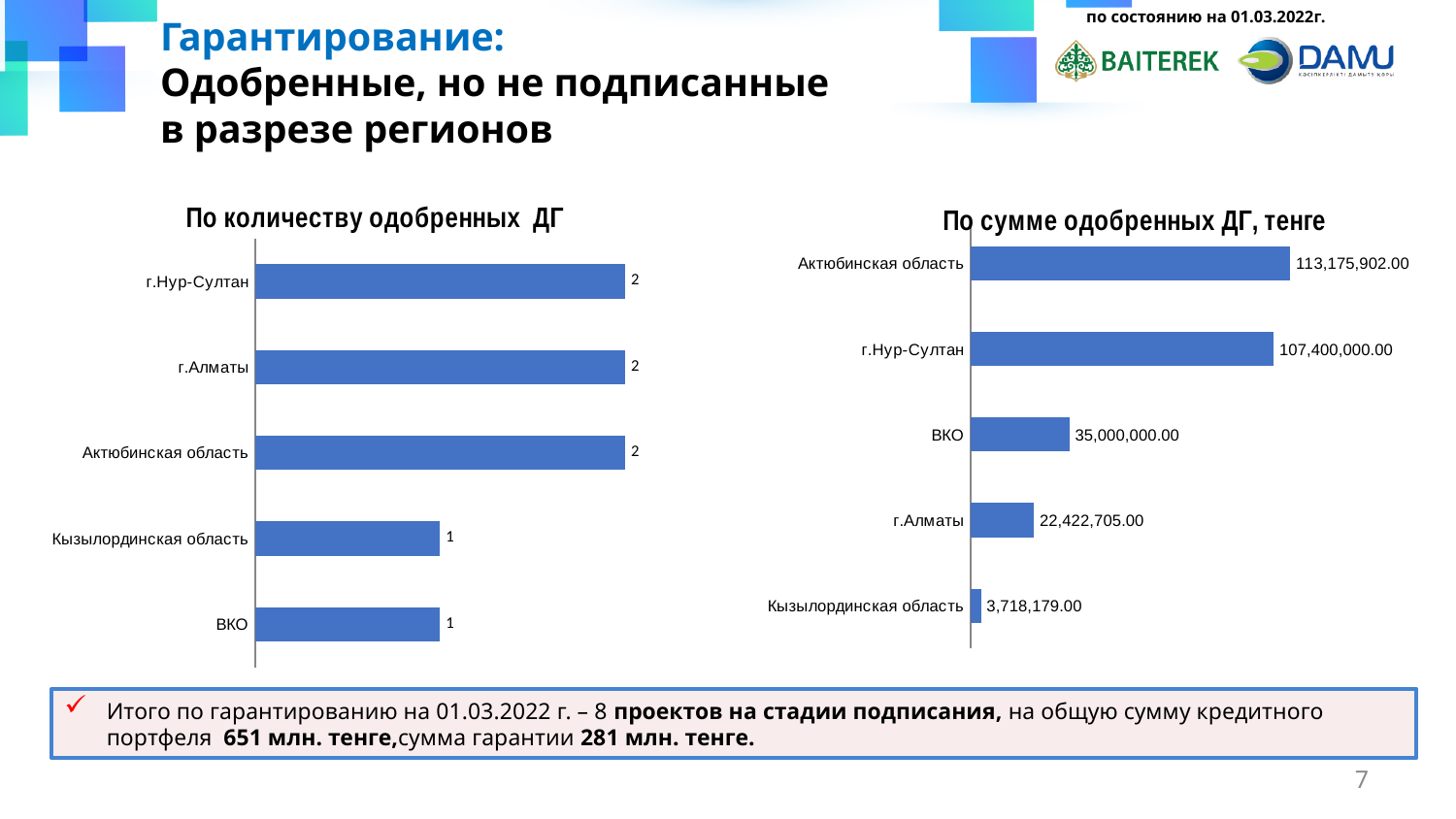
In the chart 'По количеству одобренных ДГ', what is the value for Кызылординская область? 1 In the chart 'По сумме одобренных ДГ, тенге', which is larger: the value for ВКО or the value for г.Алматы? ВКО In the chart 'По сумме одобренных ДГ, тенге', what is the difference between the values for Актюбинская область and г.Нур-Султан? 5,775,902.00 In the chart 'По сумме одобренных ДГ, тенге', what is the value for ВКО? 35,000,000.00 In the chart 'По сумме одобренных ДГ, тенге', which category has the highest value? Актюбинская область In the chart 'По количеству одобренных ДГ', how many categories are shown? 5 What is the title of the chart on the left side of the slide? По количеству одобренных ДГ In the chart 'По сумме одобренных ДГ, тенге', what is the value for г.Нур-Султан? 107,400,000.00 What kind of chart is 'По сумме одобренных ДГ, тенге'? bar chart In the chart 'По количеству одобренных ДГ', what is the value for г.Алматы? 2 In the chart 'По количеству одобренных ДГ', what is the total of all the plotted values? 8 In the chart 'По сумме одобренных ДГ, тенге', which category has the lowest value? Кызылординская область